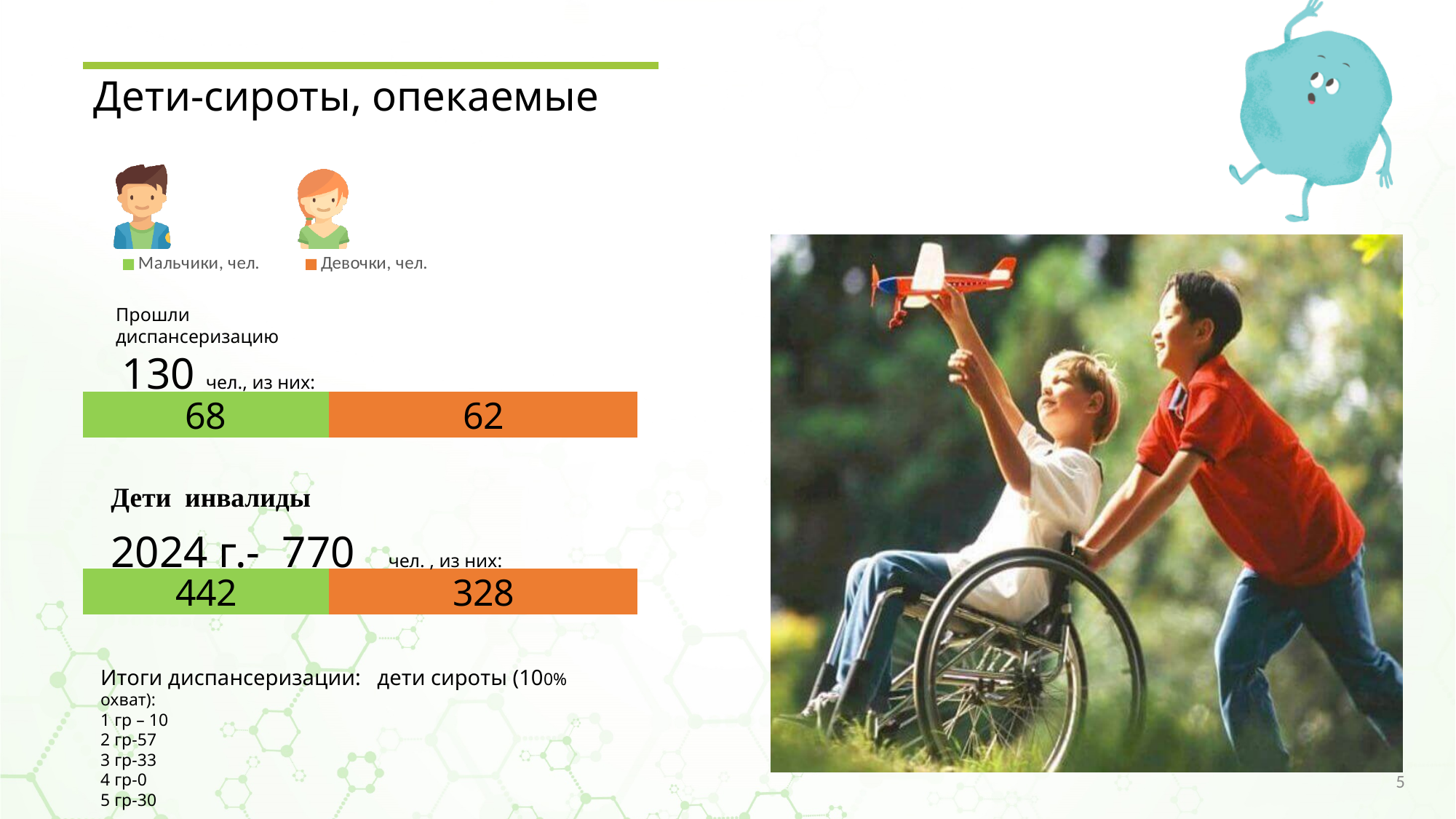
In the lower bar chart (Дети инвалиды, 2024 г.), what is the value for Девочки? 328 In the upper bar chart (Прошли диспансеризацию), what is the value for Девочки? 62 In the lower bar chart (Дети инвалиды, 2024 г.), what is the total of the stacked bar? 770 In the upper bar chart (Прошли диспансеризацию), what is the value for Мальчики? 68 In the lower bar chart (Дети инвалиды, 2024 г.), which is larger, Мальчики or Девочки? Мальчики Which colour represents Девочки in the bar charts? Orange How many series does the legend list for the bar charts? 2 In the upper bar chart (Прошли диспансеризацию), what is the total of the stacked bar? 130 In the lower bar chart (Дети инвалиды, 2024 г.), what is the difference between Мальчики and Девочки? 114 What kind of chart is used to show the Дети инвалиды data? Stacked bar chart In the lower bar chart (Дети инвалиды, 2024 г.), what is the value for Мальчики? 442 In the upper bar chart (Прошли диспансеризацию), what is the difference between Мальчики and Девочки? 6